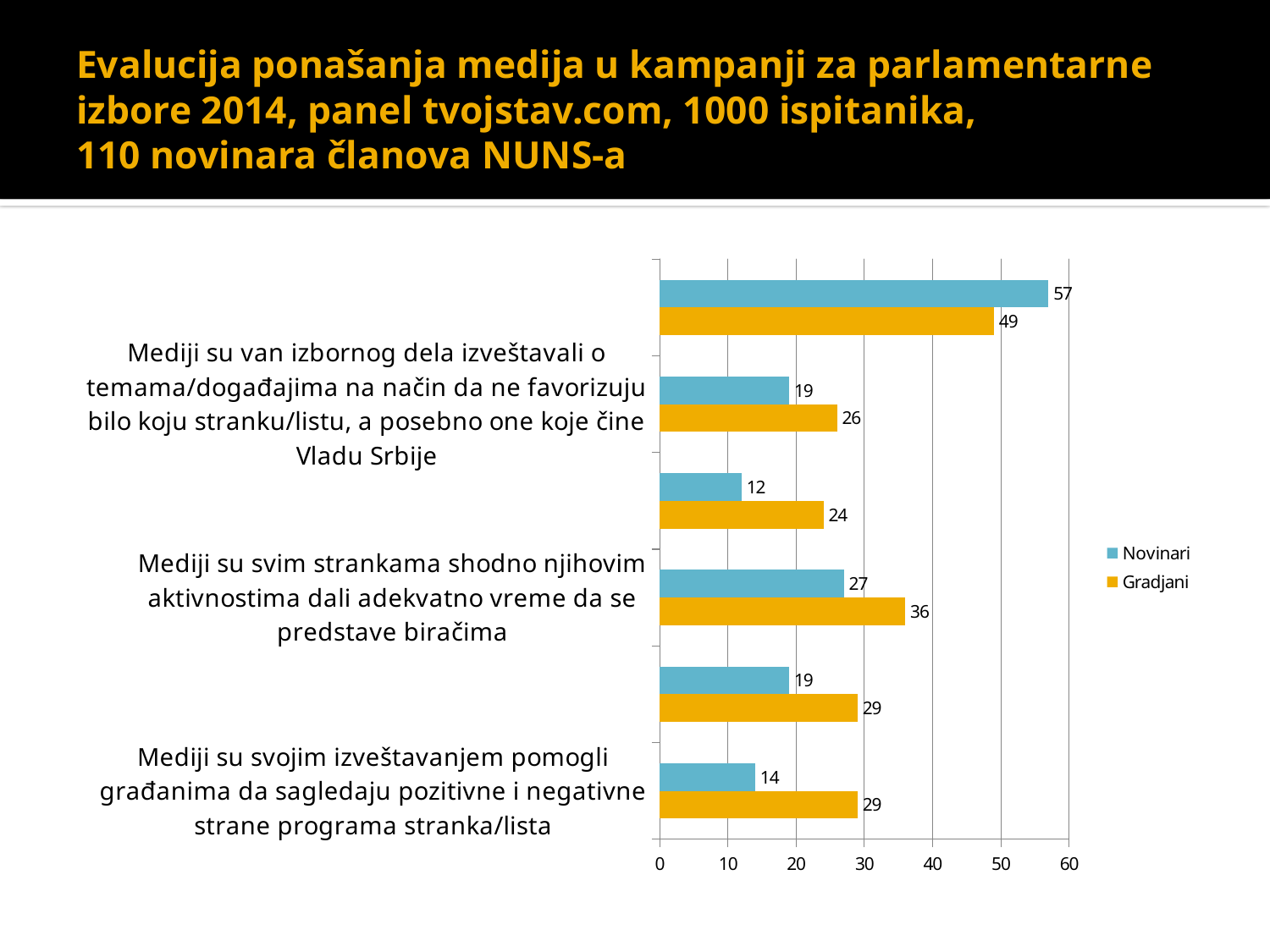
What is the value of the bottommost Novinari bar? 14 What is the value of the topmost Gradjani bar? 49 How many series does the legend list? 2 What kind of chart is shown on the slide? bar chart In the bottommost group of bars, which series has the larger value, Novinari or Gradjani? Gradjani What is the highest value shown on the chart? 57 How many groups of bars (pairs of Novinari and Gradjani bars) are plotted? 6 What are the two series named in the legend? Novinari and Gradjani What is the value of the bottommost Gradjani bar? 29 What is the value of the topmost Novinari bar? 57 In the topmost group of bars, what is the difference between the Novinari and Gradjani values? 8 What is the lowest Novinari value shown on the chart? 12